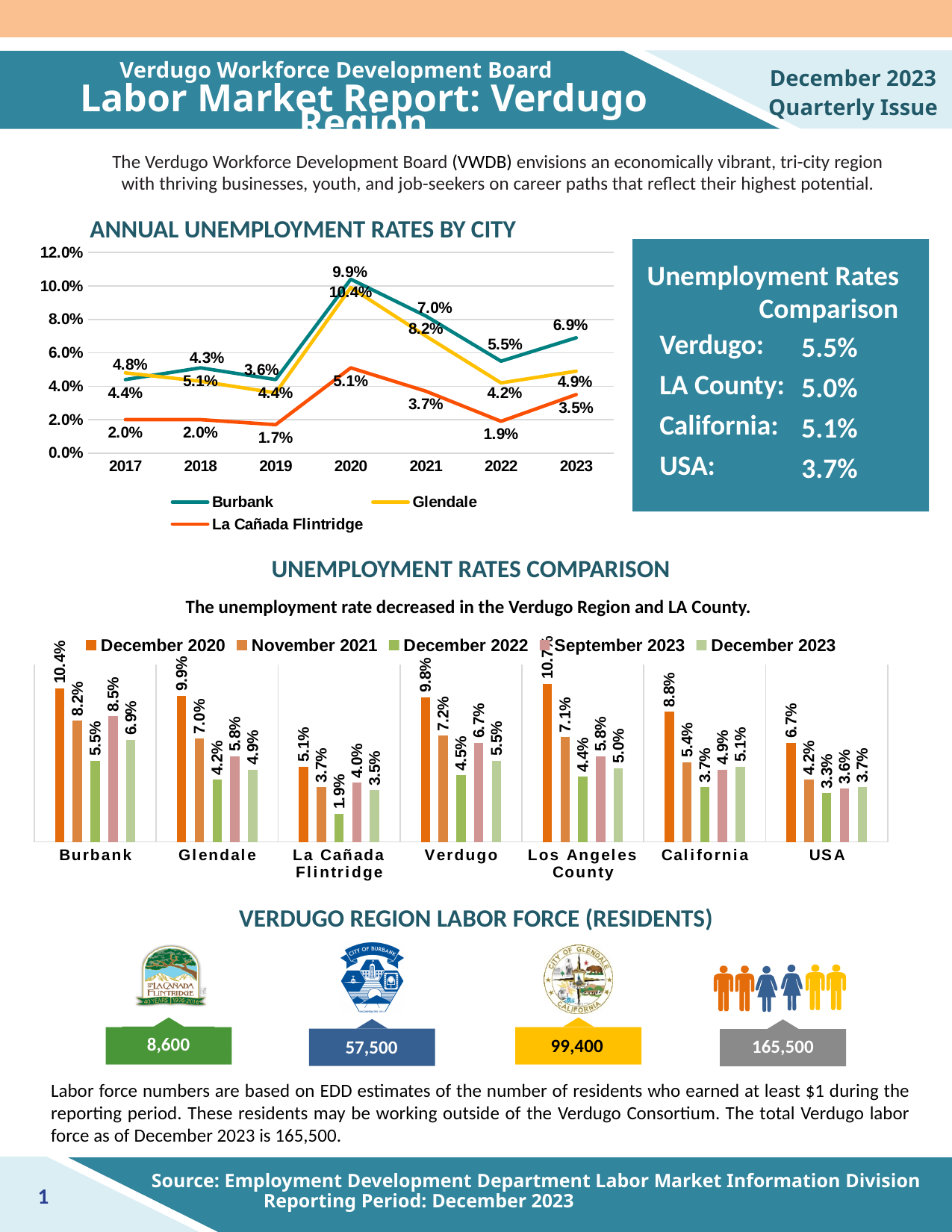
What kind of chart is the 'Annual Unemployment Rates by City' chart? line chart In the 'Unemployment Rates Comparison' bar chart, which area had the highest December 2020 unemployment rate? Los Angeles County In the 'Annual Unemployment Rates by City' chart, in which year was the La Cañada Flintridge rate highest? 2020 How many years are shown on the x axis of the 'Annual Unemployment Rates by City' chart? 7 In the 'Annual Unemployment Rates by City' chart, what was the unemployment rate for La Cañada Flintridge in 2020? 5.1% In the 'Unemployment Rates Comparison' bar chart, what is the difference between Verdugo's December 2023 rate and its December 2022 rate? 1.0% In the 'Unemployment Rates Comparison' bar chart, which area had the lowest December 2022 unemployment rate? La Cañada Flintridge In the 'Unemployment Rates Comparison' bar chart, which is larger: the December 2023 rate for California or for USA? California How many series does the legend of the 'Annual Unemployment Rates by City' chart list? 3 In the 'Unemployment Rates Comparison' bar chart, what was the December 2020 unemployment rate for Burbank? 10.4% In the 'Annual Unemployment Rates by City' chart, what was the unemployment rate for La Cañada Flintridge in 2023? 3.5% How many series does the legend of the 'Unemployment Rates Comparison' bar chart list? 5